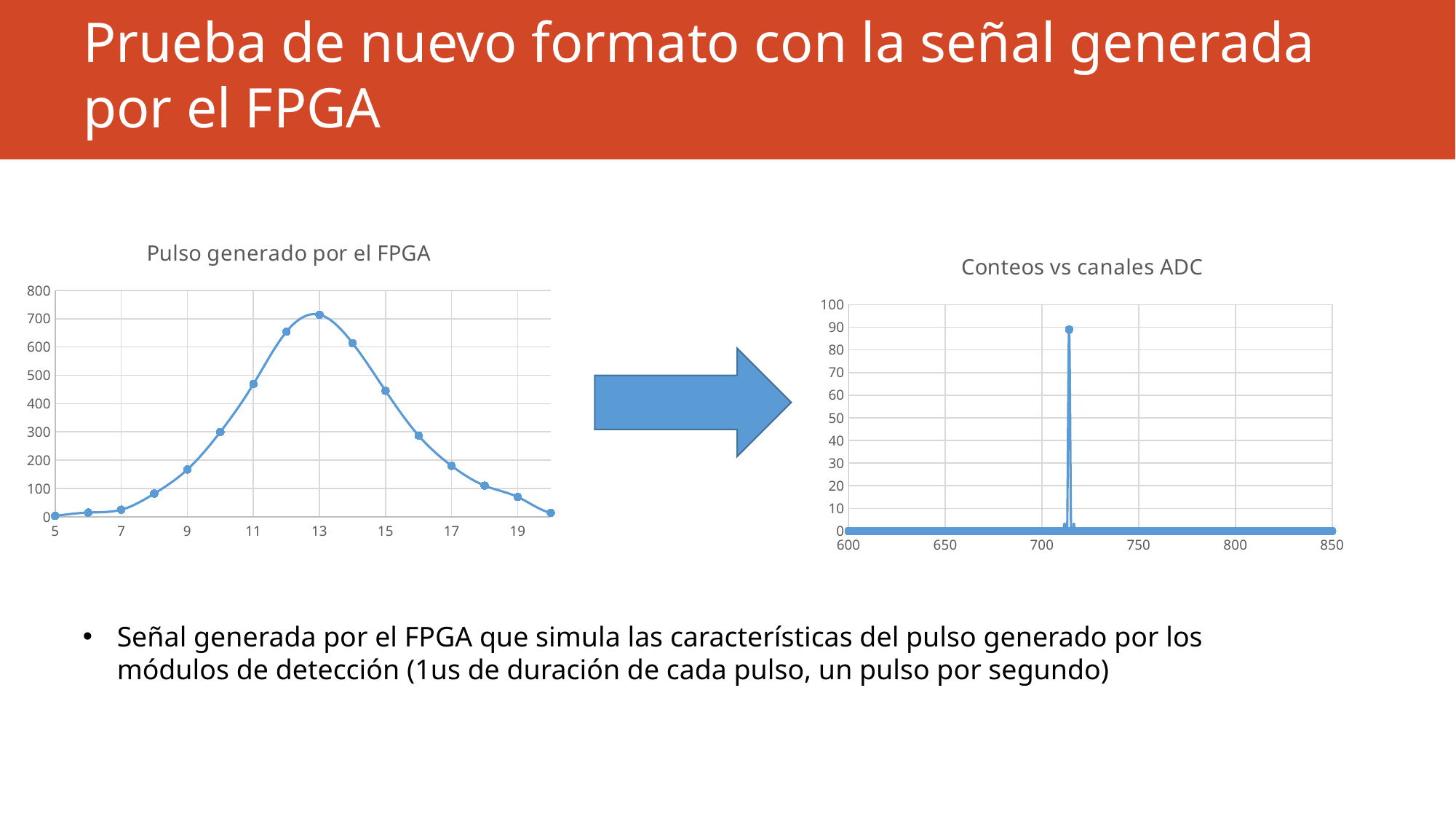
In the 'Conteos vs canales ADC' chart, is the peak value greater or less than 80? greater In the 'Pulso generado por el FPGA' chart, do the values rise or fall between x = 13 and x = 20? fall What kind of chart is the 'Pulso generado por el FPGA' chart? line chart In the 'Pulso generado por el FPGA' chart, at which x value does the pulse reach its highest point? 13 What kind of chart is the 'Conteos vs canales ADC' chart? line chart In the 'Pulso generado por el FPGA' chart, do the values rise or fall between x = 5 and x = 13? rise In the 'Pulso generado por el FPGA' chart, is the value at x = 9 greater or less than 200? less In the 'Pulso generado por el FPGA' chart, which is larger, the value at x = 11 or the value at x = 16? x = 11 In the 'Pulso generado por el FPGA' chart, is the value at x = 15 greater or less than 400? greater What is the title of the chart on the right side of the slide? Conteos vs canales ADC How many data points are plotted in the 'Pulso generado por el FPGA' chart? 16